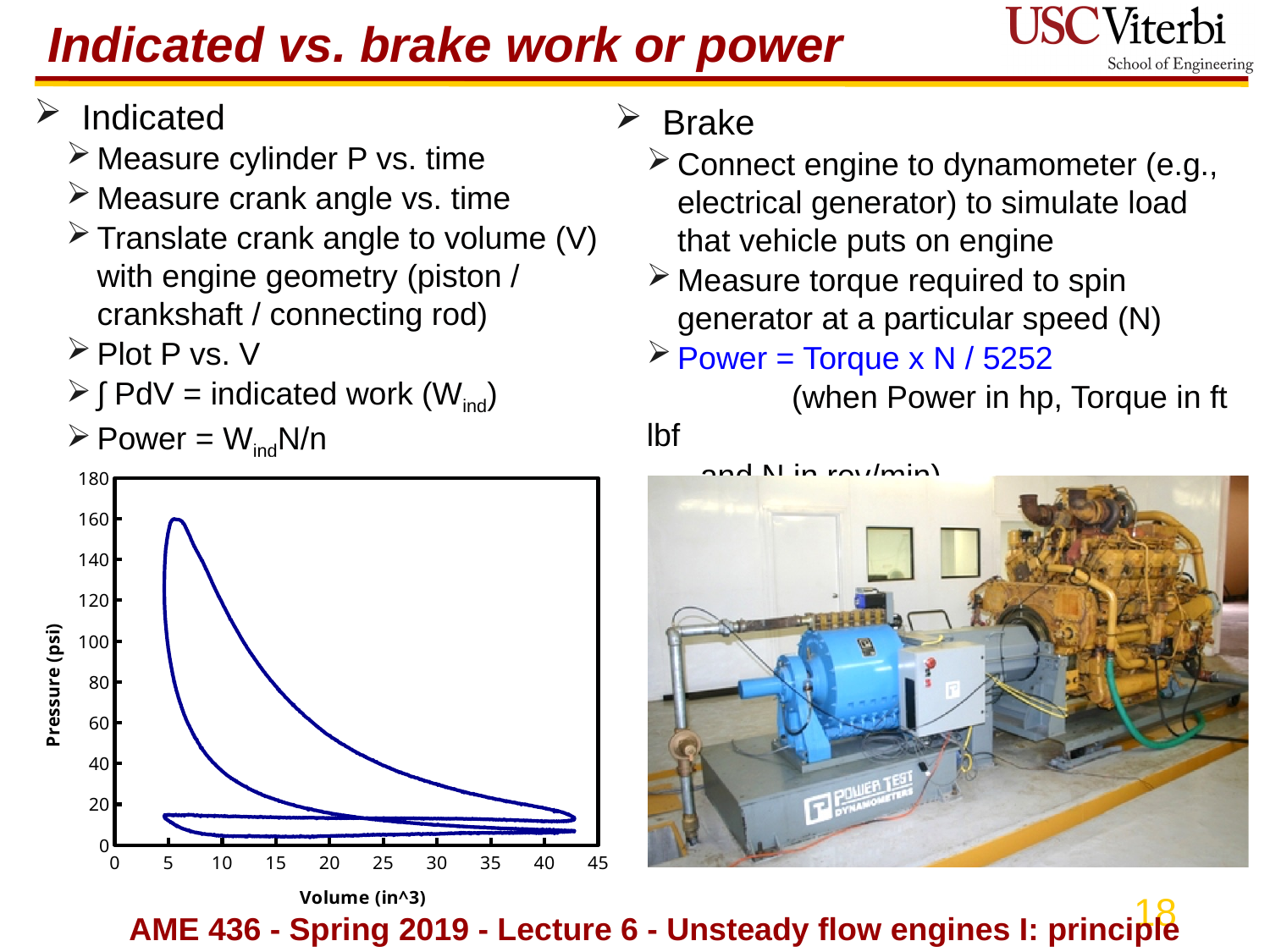
How many curves (data series) are plotted on the chart? 1 At the largest volume reached by the curve (around 42 in^3), is the pressure greater or less than 40 psi? less Is the peak pressure reached by the curve greater or less than 140 psi? greater What kind of chart is shown on the slide? line chart What is the highest tick value shown on the y axis? 180 Along the upper branch of the loop, does the pressure rise or fall as volume increases from 5 to 40 in^3? fall What is the label of the x axis of the chart? Volume (in^3) Is the peak pressure reached by the curve greater or less than 180 psi? less What is the label of the y axis of the chart? Pressure (psi)